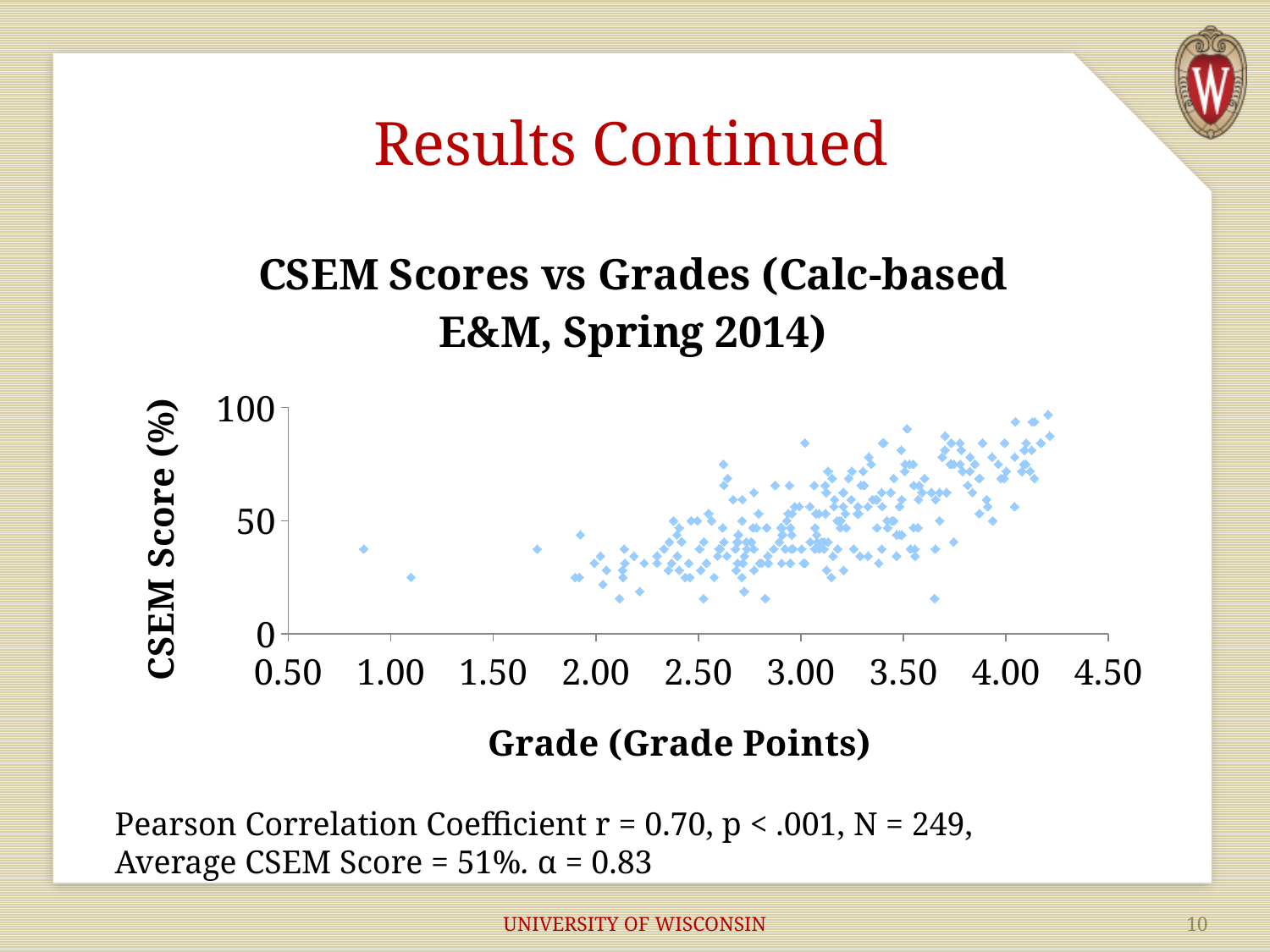
Is the CSEM score of the highest point on the chart greater or less than 50? greater What kind of chart is shown on the slide? Scatter plot Is the CSEM score of the leftmost point (near a grade of 0.85) greater or less than 50? less Are most of the points with a grade above 4.00 greater or less than 50 on the CSEM score axis? greater How many data points (N) are plotted in the chart, according to the slide? 249 What is the title of the chart? CSEM Scores vs Grades (Calc-based E&M, Spring 2014) Do CSEM scores generally rise or fall as grade points increase along the x axis? Rise What is the label of the vertical axis of the chart? CSEM Score (%) What is the highest tick value shown on the CSEM Score axis? 100 Which has the higher CSEM score: the point near a grade of 1.10 or the point near a grade of 0.85? The point near 0.85